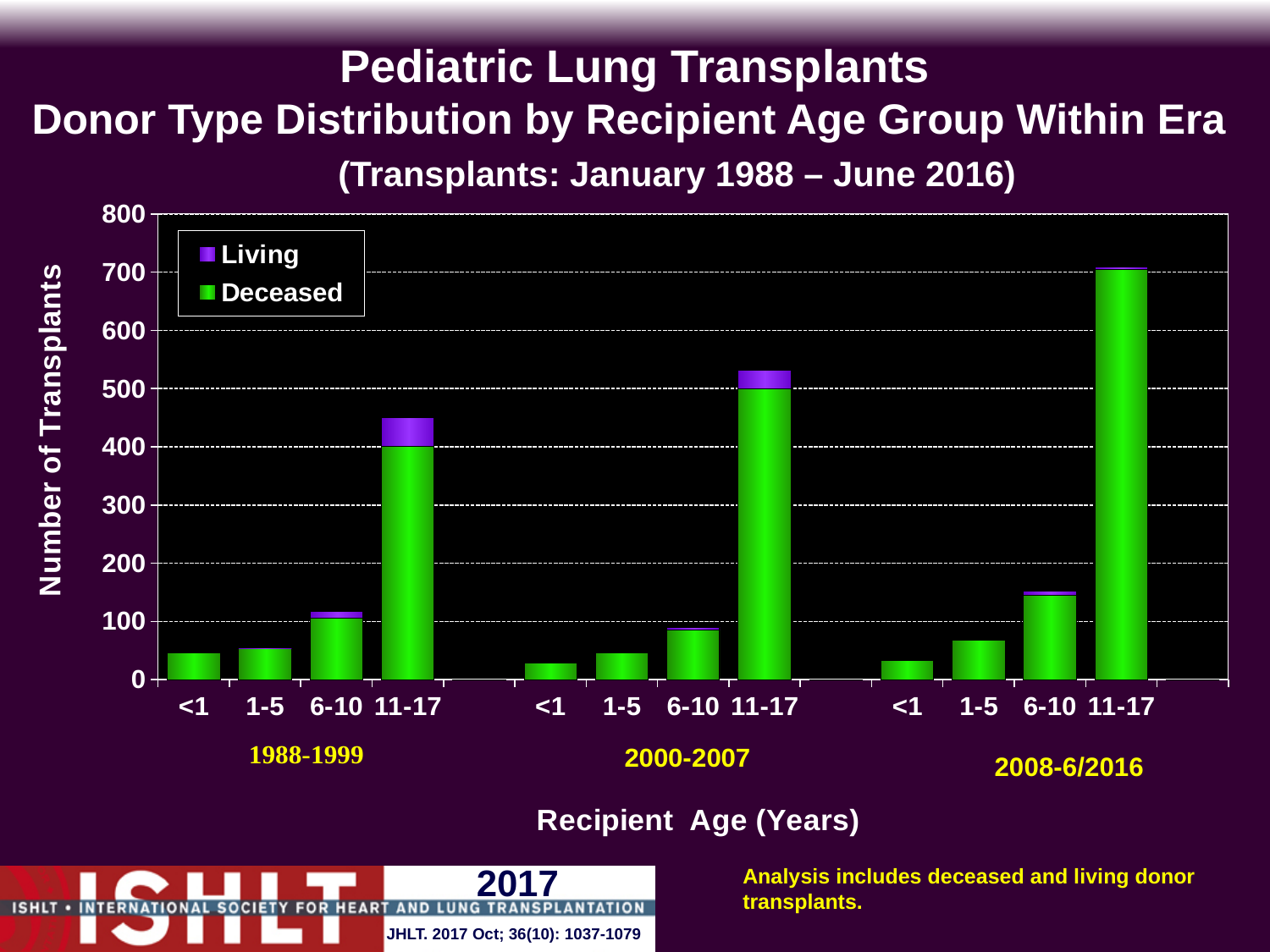
Is the total number of transplants for the <1 age group in the 2000-2007 era greater or less than 100? less What kind of chart is shown on the slide? bar chart What are the two series named in the legend? Living and Deceased Is the total number of transplants for the 11-17 age group in the 2008-6/2016 era greater or less than 600? greater How many bars are plotted in total across all eras? 12 Within the 2000-2007 era, do the bars rise or fall as recipient age increases from <1 to 11-17? rise Which recipient age group in the 2008-6/2016 era has the tallest bar? 11-17 How many series does the legend list? 2 Which era has the tallest bar for the 11-17 age group? 2008-6/2016 How many era groups are shown along the x axis? 3 Is the total number of transplants for the 11-17 age group in the 1988-1999 era greater or less than 400? greater Which is larger: the 11-17 bar in the 2000-2007 era or the 11-17 bar in the 2008-6/2016 era? 2008-6/2016